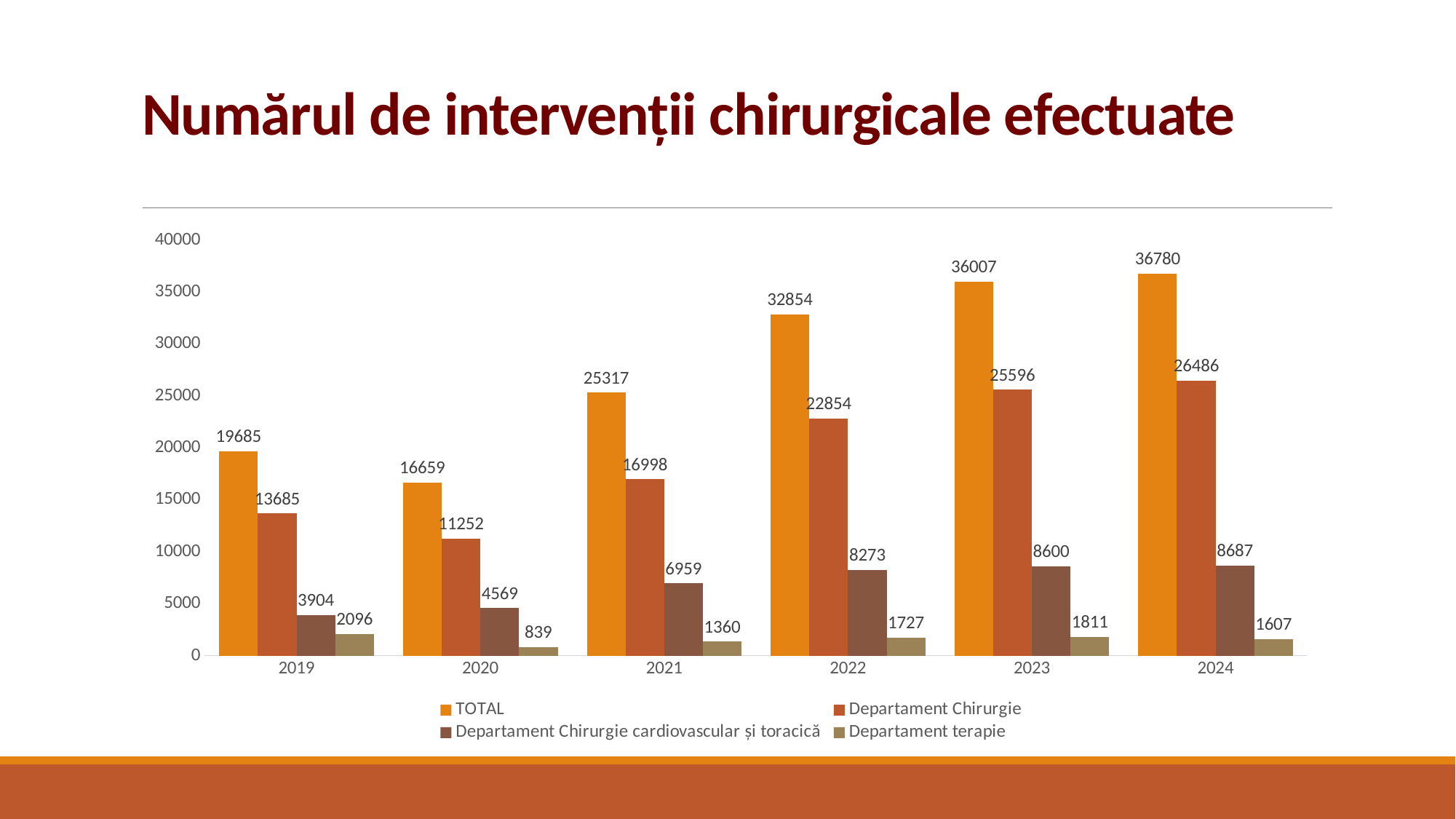
What is the value for Departament Chirurgie cardiovascular și toracică in 2021? 6959 In which year is the TOTAL highest? 2024 How many series does the legend list? 4 In which year is the Departament terapie value lowest? 2020 What is the title of the slide? Numărul de intervenții chirurgicale efectuate What is the TOTAL value for 2022? 32854 What is the value for Departament Chirurgie in 2020? 11252 What kind of chart is shown on the slide? bar chart How many years are shown on the x axis? 6 What is the difference between the TOTAL values for 2024 and 2023? 773 Which is larger: Departament Chirurgie in 2019 or Departament Chirurgie in 2021? Departament Chirurgie in 2021 What is the value for Departament terapie in 2023? 1811